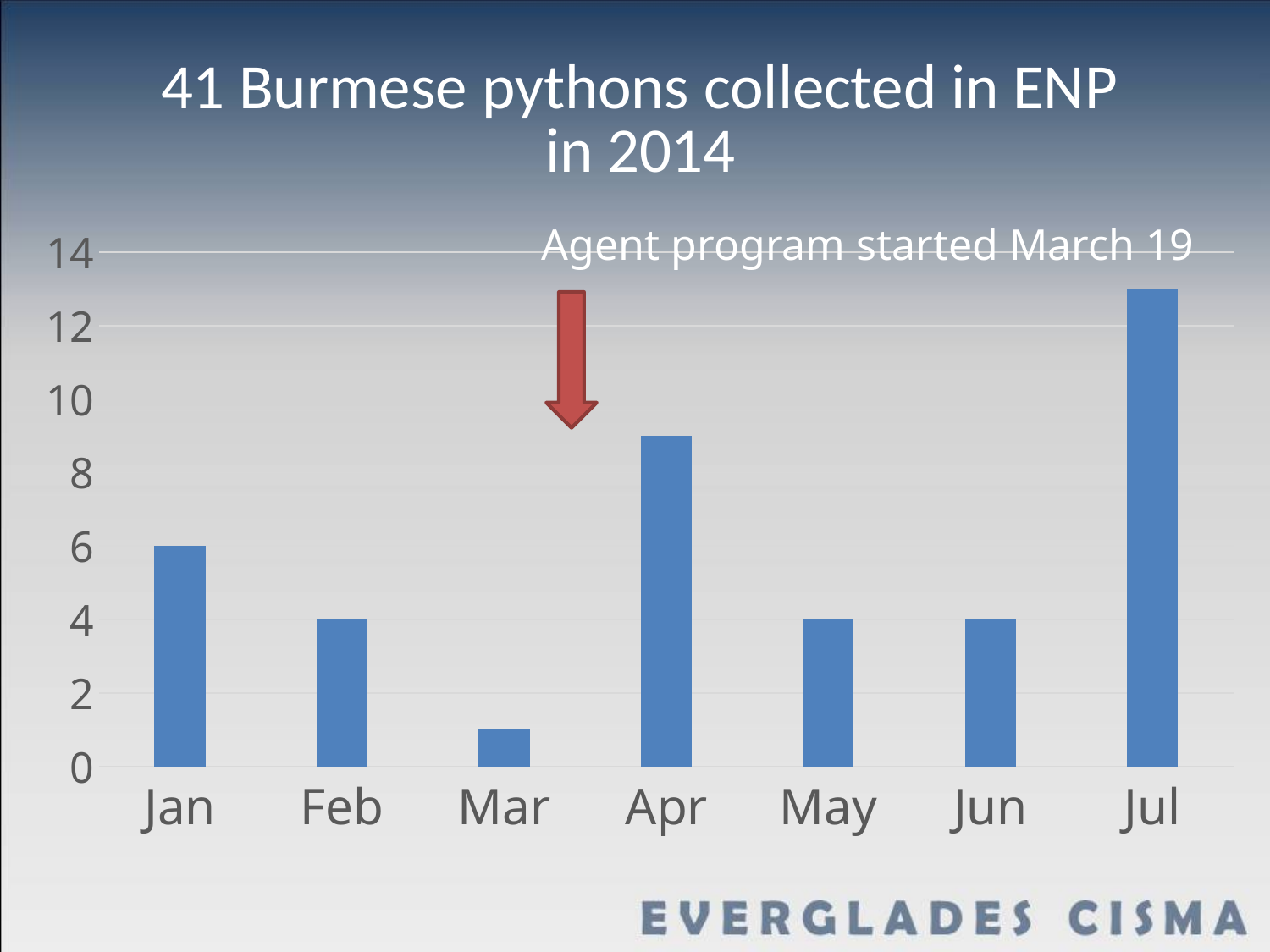
Is the value for Mar greater or less than 2? less How many Burmese pythons were collected in Feb? 4 What is the difference between the values for Jan and Feb? 2 How many Burmese pythons were collected in Jun? 4 Is the value for Jul greater or less than 12? greater Is the value for Apr greater or less than 8? greater How many Burmese pythons were collected in Jan? 6 According to the annotation on the chart, when did the agent program start? March 19 How many months are shown on the x axis? 7 What type of chart is shown on the slide? bar chart Which month has the lowest number of pythons collected? Mar Which month has the highest number of pythons collected? Jul